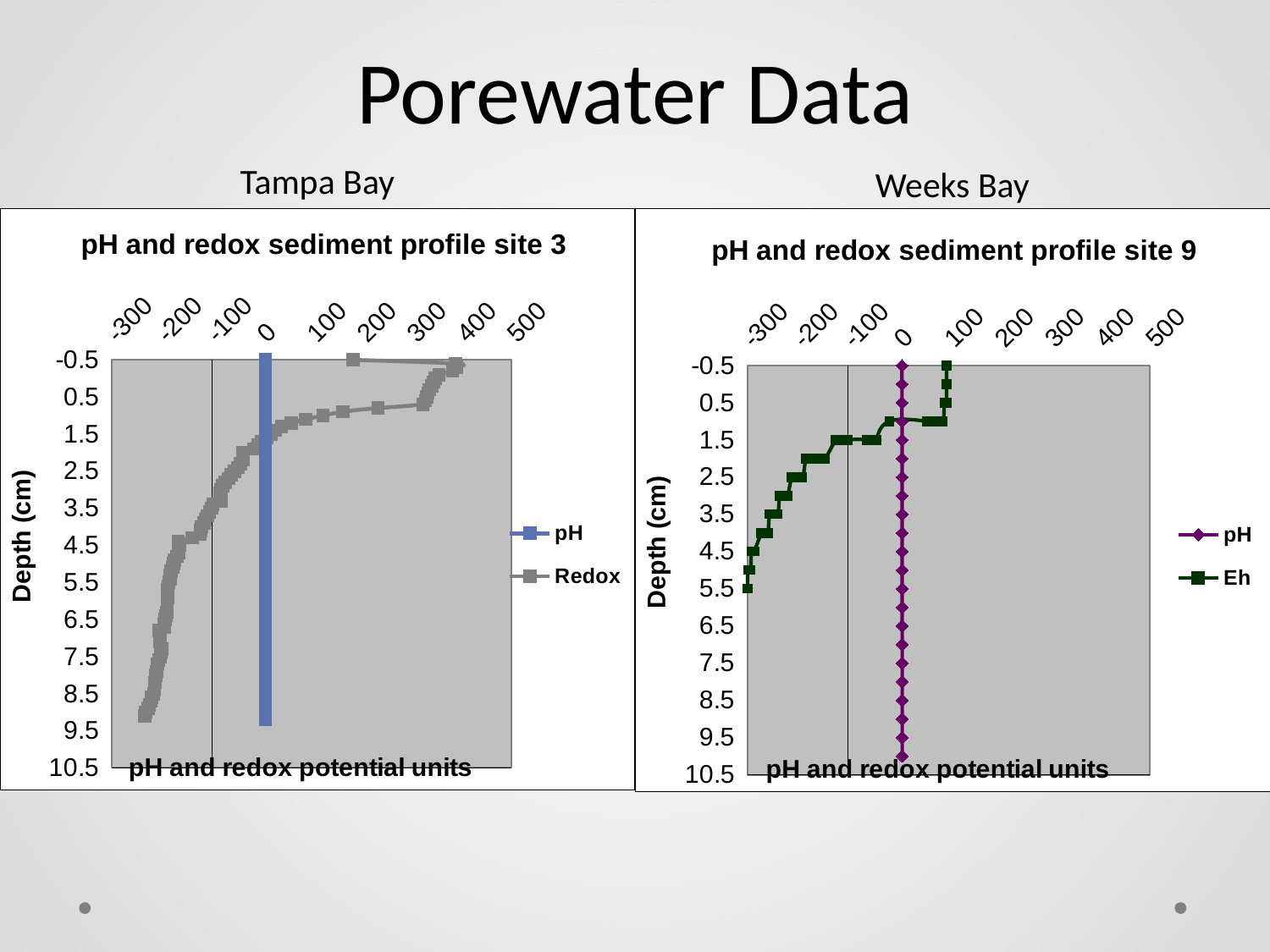
On the right chart (site 9), is the Eh value at a depth of -0.5 cm greater or less than 0? greater On the right chart (pH and redox sediment profile site 9), what are the two series named in the legend? pH and Eh What kind of chart is the right chart (pH and redox sediment profile site 9)? line chart On the right chart (site 9), which is larger: the Eh value at a depth of 0.5 cm or at a depth of 4.5 cm? 0.5 cm On the right chart (site 9), does the Eh value rise or fall as depth increases from -0.5 cm to 5.5 cm? fall What is the title of the left chart on the slide? pH and redox sediment profile site 3 On the left chart (site 3), does the Redox value rise or fall as depth increases from -0.5 cm to 9.5 cm? fall On the left chart (pH and redox sediment profile site 3), how many series does the legend list? 2